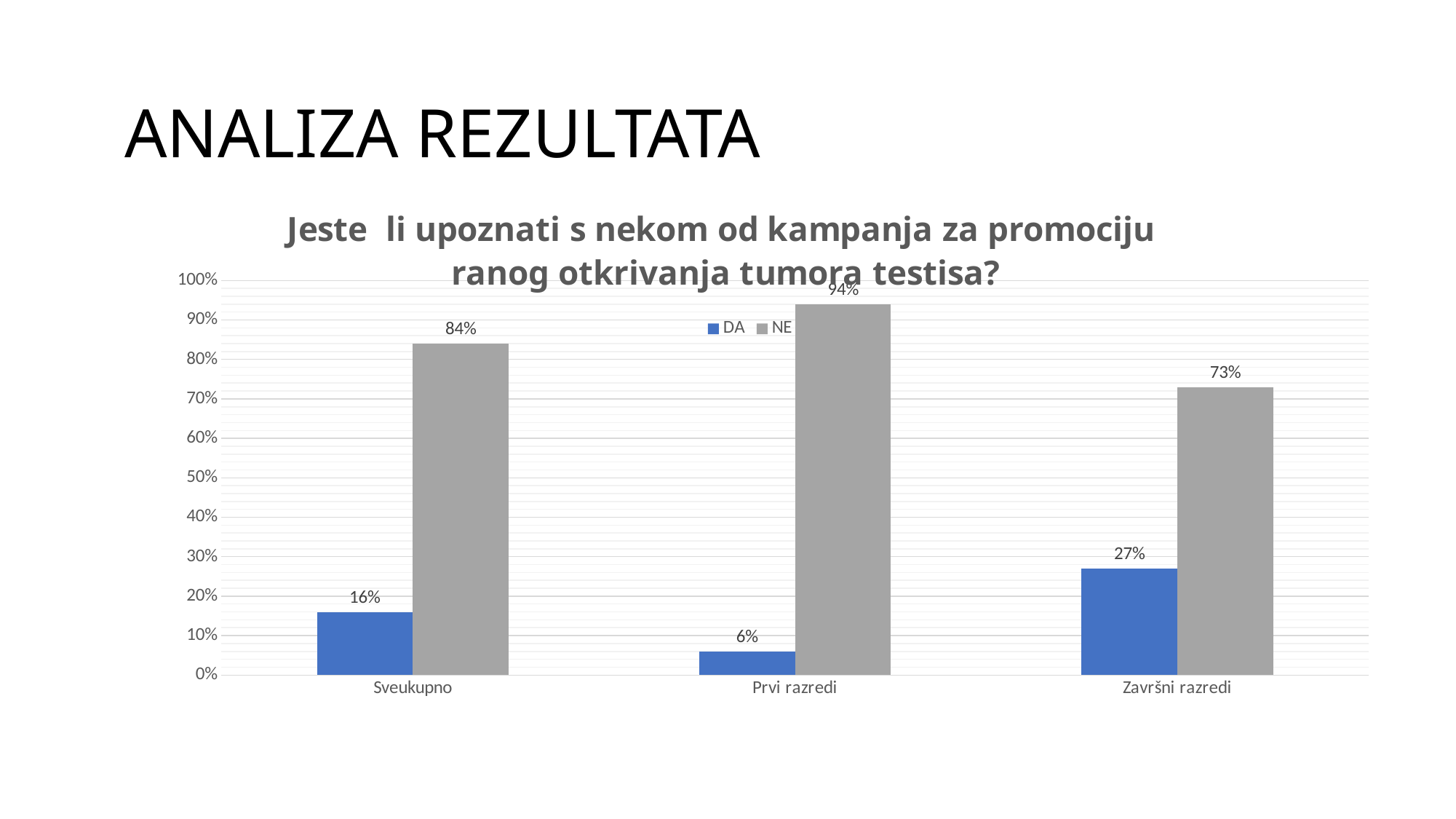
Which is larger, the DA value for Završni razredi or the DA value for Sveukupno? Završni razredi How many series does the legend list? 2 What kind of chart is shown on the slide? Bar chart What is the difference between the NE and DA values in the Sveukupno category? 68% What is the value for NE in the Prvi razredi category? 94% Which colour represents the NE series? Grey What is the value for DA in the Sveukupno category? 16% What is the value for NE in the Završni razredi category? 73% How many categories are shown on the x axis? 3 Which category has the lowest DA value? Prvi razredi What is the value for DA in the Završni razredi category? 27% Which category has the highest NE value? Prvi razredi